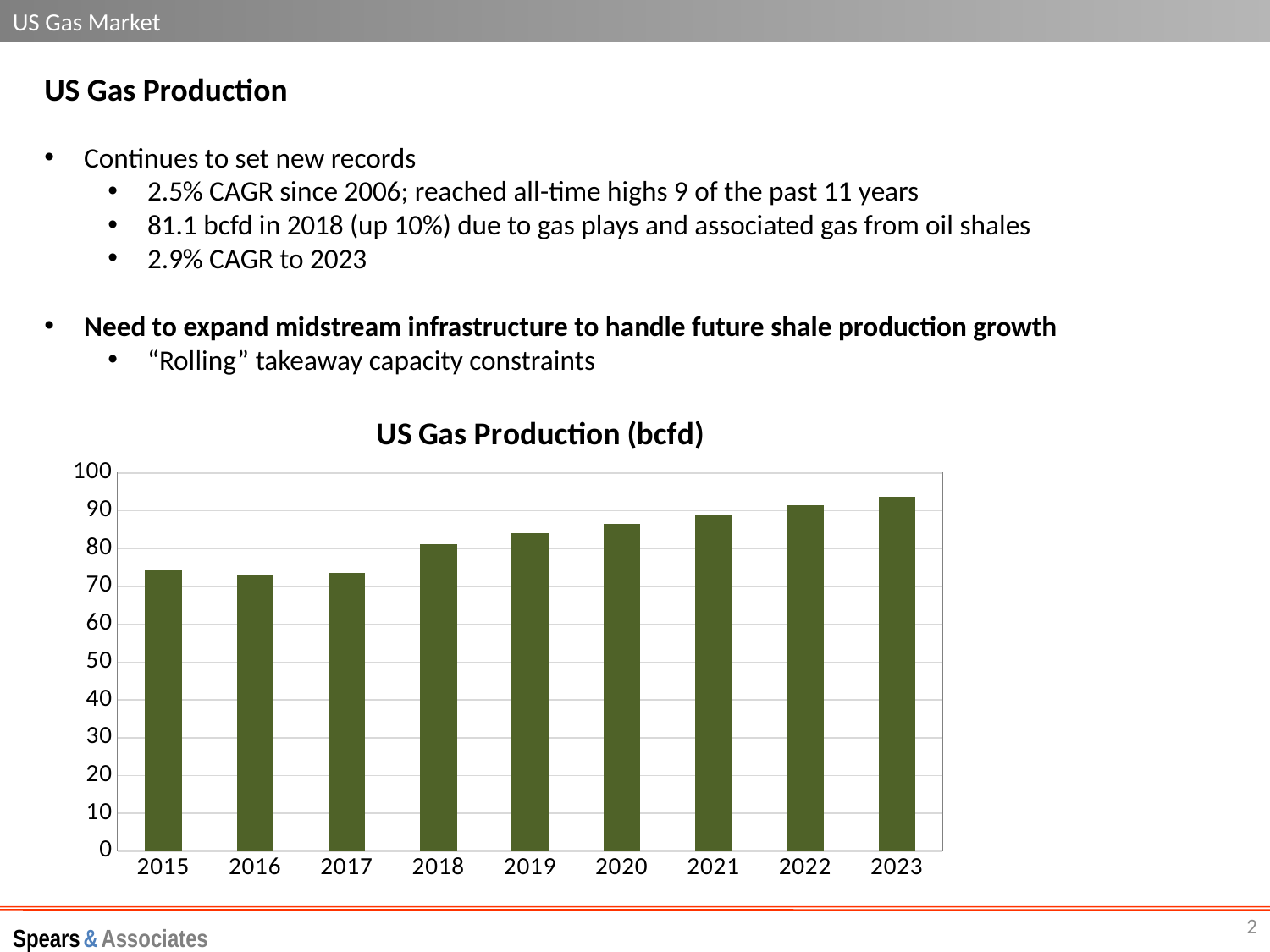
Is the value for 2023 greater or less than 100? less What kind of chart is shown on the slide? bar chart Which year has the highest US gas production in the chart? 2023 Is the value for 2019 greater or less than 80? greater Is the value for 2015 greater or less than 70? greater What is the highest value shown on the y axis of the chart? 100 Do the values in the chart generally rise or fall from 2015 to 2023? rise What is the title of the chart? US Gas Production (bcfd) Which is larger, the value for 2018 or the value for 2017? 2018 Which is larger, the value for 2015 or the value for 2023? 2023 How many years are shown on the x axis of the chart? 9